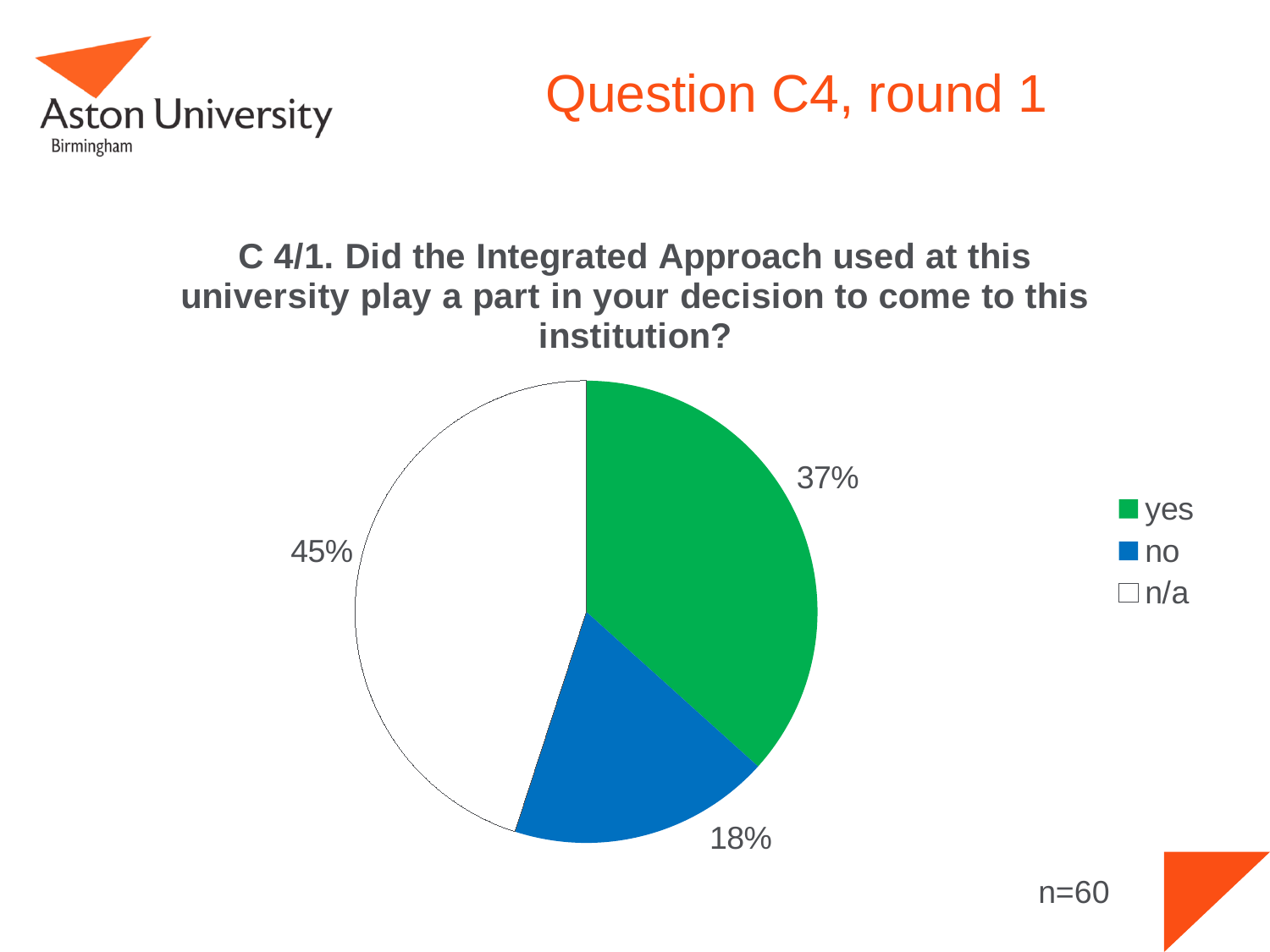
What percentage of respondents answered "n/a"? 45% How many categories does the legend list? 3 Which response category has the smallest share of the pie? no What percentage of respondents answered "yes"? 37% What colour is the "yes" slice? green What percentage of respondents answered "no"? 18% What kind of chart is shown on the slide? pie chart Which response category has the largest share of the pie? n/a Which slice is larger, "yes" or "no"? yes What is the sample size (n) shown on the slide? n=60 What is the difference in percentage points between the "yes" and "no" slices? 19 What is the difference in percentage points between the "n/a" and "yes" slices? 8